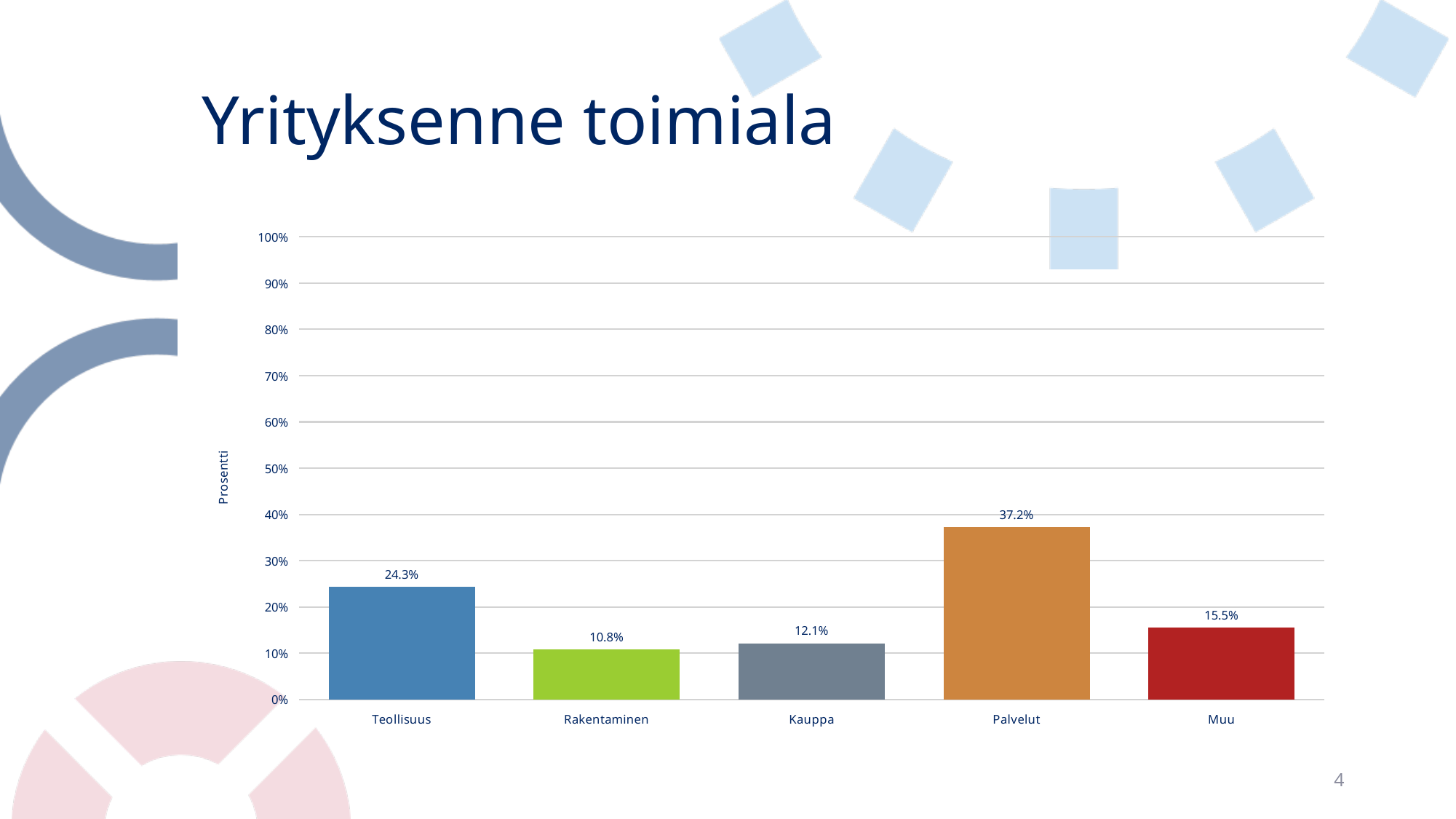
What is the label of the vertical axis? Prosentti What is the value for Teollisuus? 24.3% What kind of chart is shown on the slide? bar chart What is the value for Muu? 15.5% What is the difference between the values for Palvelut and Teollisuus? 12.9% Which is larger, the value for Kauppa or the value for Muu? Muu What is the value for Rakentaminen? 10.8% What is the value for Palvelut? 37.2% How many categories are shown on the x axis? 5 Is the value for Palvelut greater or less than 40%? less Which category has the highest value? Palvelut Which category has the lowest value? Rakentaminen